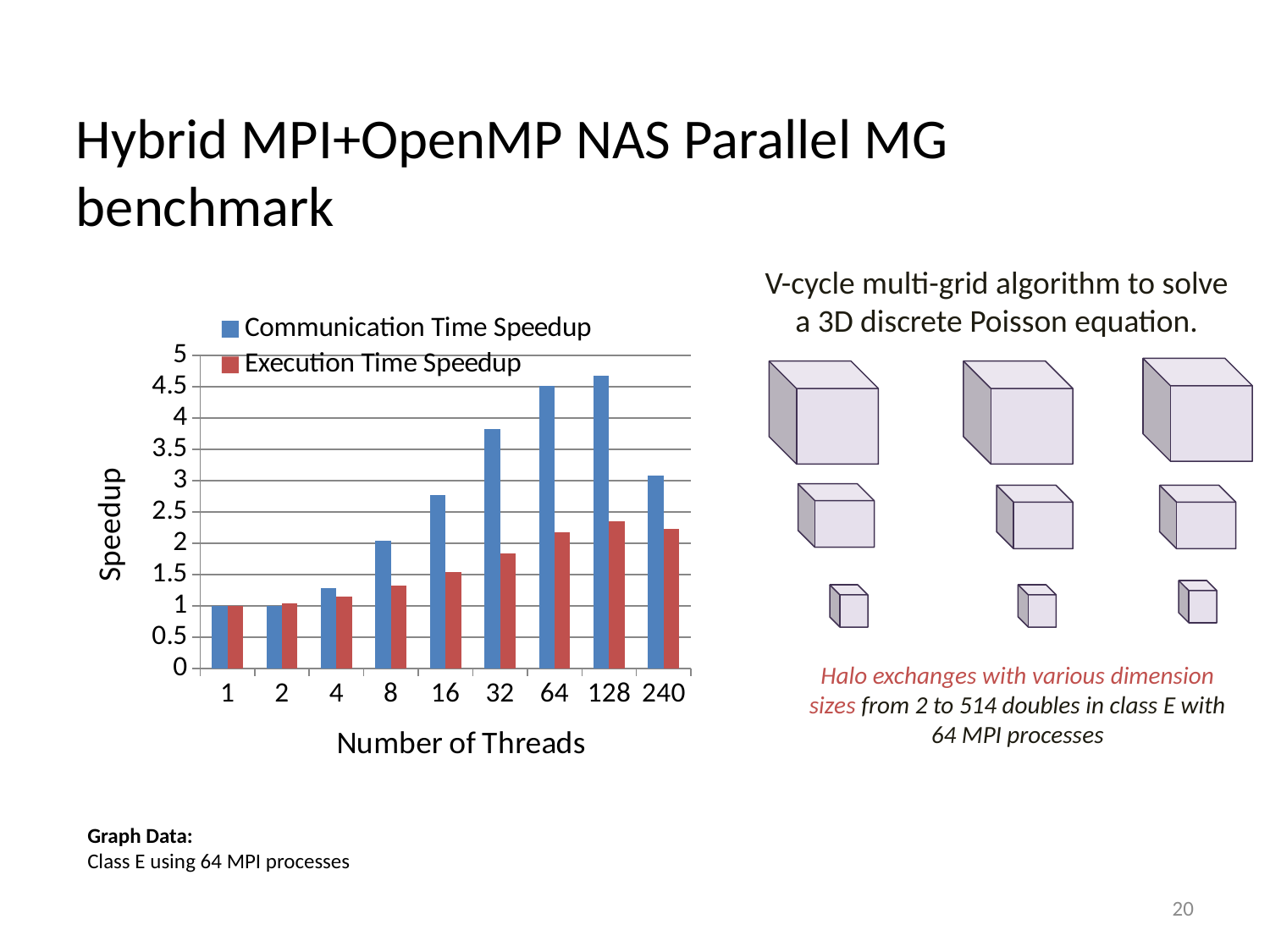
What is the label of the y axis? Speedup At 64 threads, which is larger: Communication Time Speedup or Execution Time Speedup? Communication Time Speedup Does the Communication Time Speedup rise or fall from 1 thread to 128 threads? rise Is the Communication Time Speedup at 64 threads greater or less than 4? greater What kind of chart is shown on the slide? bar chart How many thread counts are shown on the x axis? 9 How many series does the legend list? 2 Is the Communication Time Speedup at 16 threads greater or less than 2.5? greater What is the Communication Time Speedup at 1 thread? 1 Is the Execution Time Speedup at 8 threads greater or less than 1.5? less At which number of threads is the Communication Time Speedup highest? 128